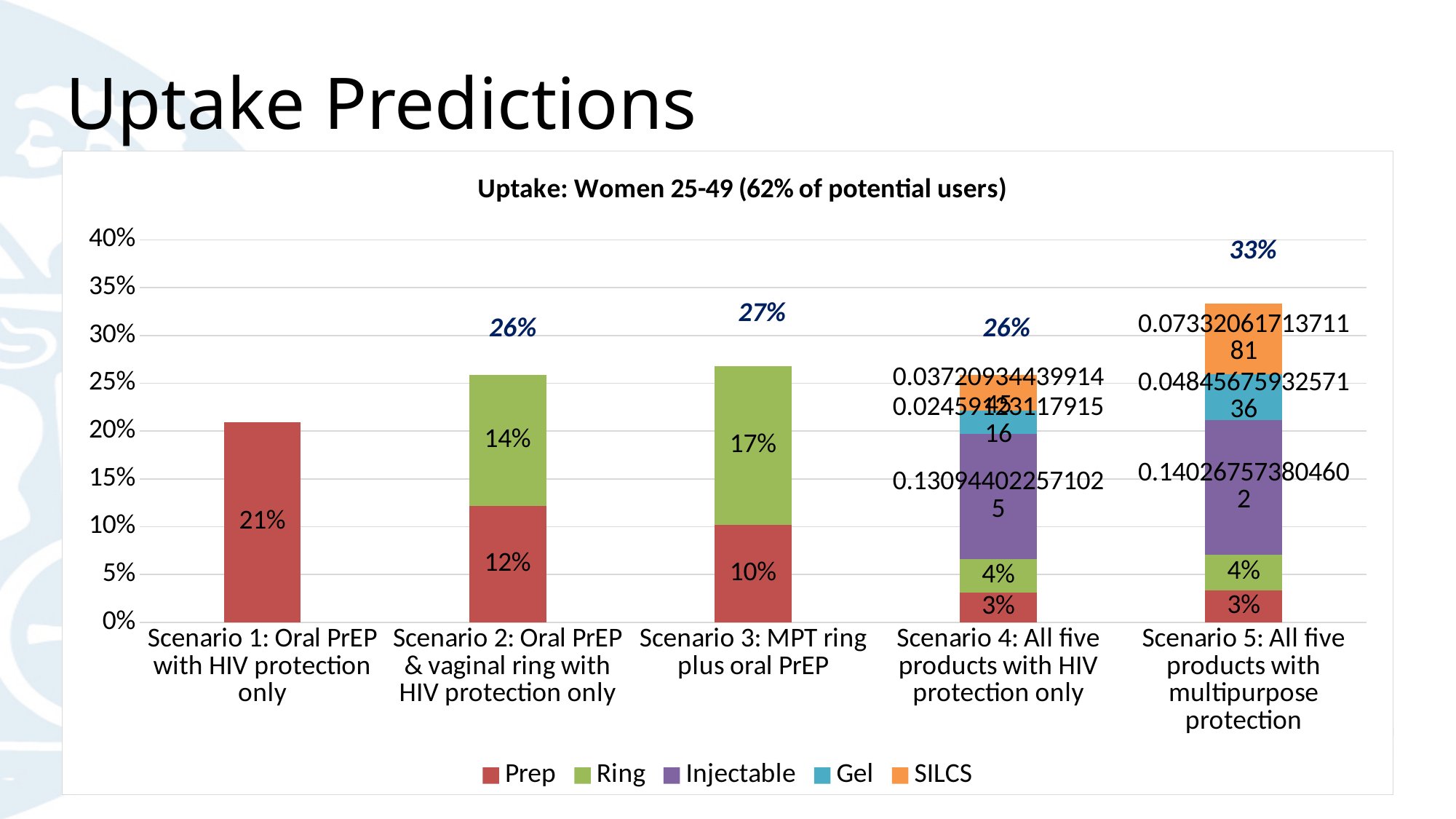
What kind of chart is shown on the slide? Stacked bar chart What is the title of the chart? Uptake: Women 25-49 (62% of potential users) What is the total uptake shown for Scenario 5: All five products with multipurpose protection? 33% How many scenarios are plotted along the x axis? 5 How many series does the legend list? 5 What is the Prep value for Scenario 1: Oral PrEP with HIV protection only? 21% Which has the larger Prep value, Scenario 2 or Scenario 3? Scenario 2 Which scenario has the lowest total uptake? Scenario 1: Oral PrEP with HIV protection only What is the Ring value for Scenario 3: MPT ring plus oral PrEP? 17% What is the Prep value for Scenario 2: Oral PrEP & vaginal ring with HIV protection only? 12% How much larger is the Ring value in Scenario 3 than in Scenario 2? 3% Which scenario has the highest total uptake? Scenario 5: All five products with multipurpose protection